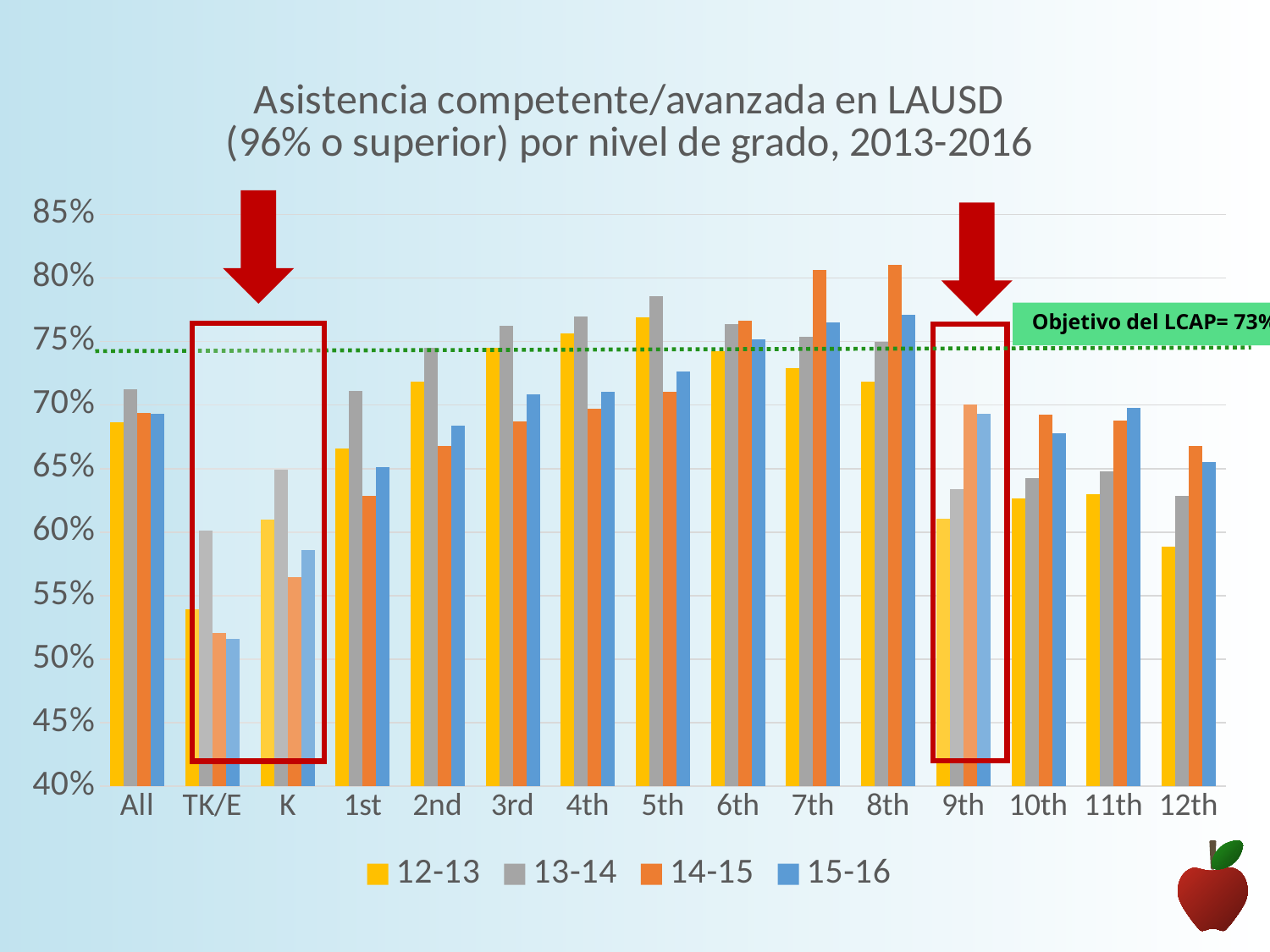
Is the 12-13 value for TK/E greater or less than 55%? less What LCAP target value is marked by the dotted line? 73% How many series does the legend list? 4 Do the 12-13 values rise or fall from TK/E through 5th grade? rise Which grade level has the lowest 12-13 value? TK/E What kind of chart is shown on the slide? bar chart How many grade-level categories are shown on the x axis? 15 For the 12-13 series, which is larger: TK/E or K? K Is the 14-15 value for 8th grade greater or less than 80%? greater Is the 12-13 value for 12th grade greater or less than 60%? less For the 12-13 series, which is larger: 8th or 9th? 8th